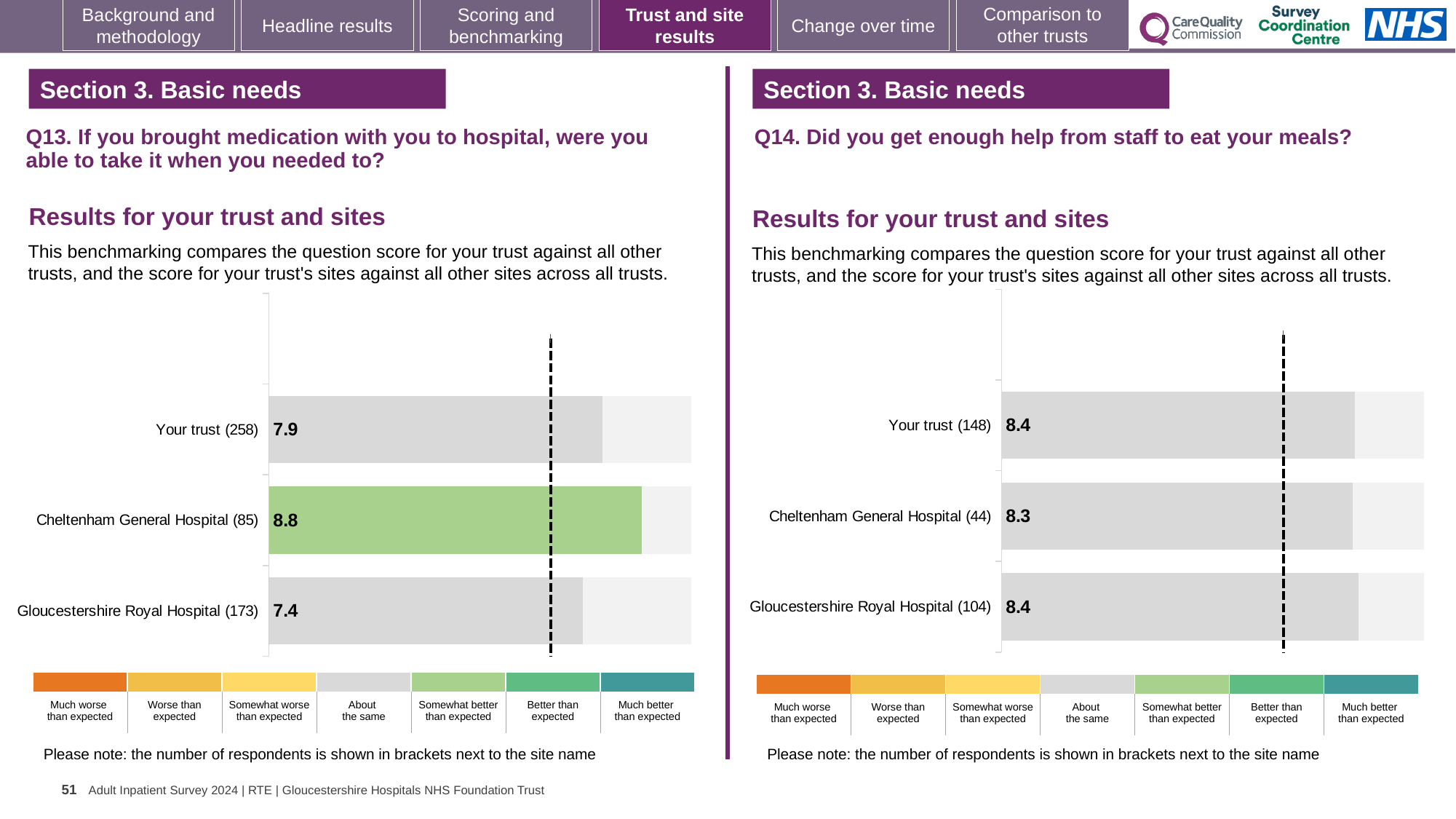
In the Q14 chart (right), what is the score for Your trust (148)? 8.4 In the Q13 chart (left), what is the score for Your trust (258)? 7.9 In the Q14 chart (right), what is the score for Cheltenham General Hospital (44)? 8.3 In the Q14 chart (right), what is the score for Gloucestershire Royal Hospital (104)? 8.4 In the Q13 chart (left), which bar is coloured green rather than grey? Cheltenham General Hospital (85) In the Q13 chart (left), what is the difference between the scores for Cheltenham General Hospital and Gloucestershire Royal Hospital? 1.4 In the Q14 chart (right), how many bars are plotted? 3 In the Q13 chart (left), which site or trust has the highest score? Cheltenham General Hospital (85) What type of chart is used in the Q13 chart (left)? Bar chart In the Q13 chart (left), what is the score for Gloucestershire Royal Hospital (173)? 7.4 In the Q13 chart (left), what is the score for Cheltenham General Hospital (85)? 8.8 In the Q13 chart (left), which site or trust has the lowest score? Gloucestershire Royal Hospital (173)